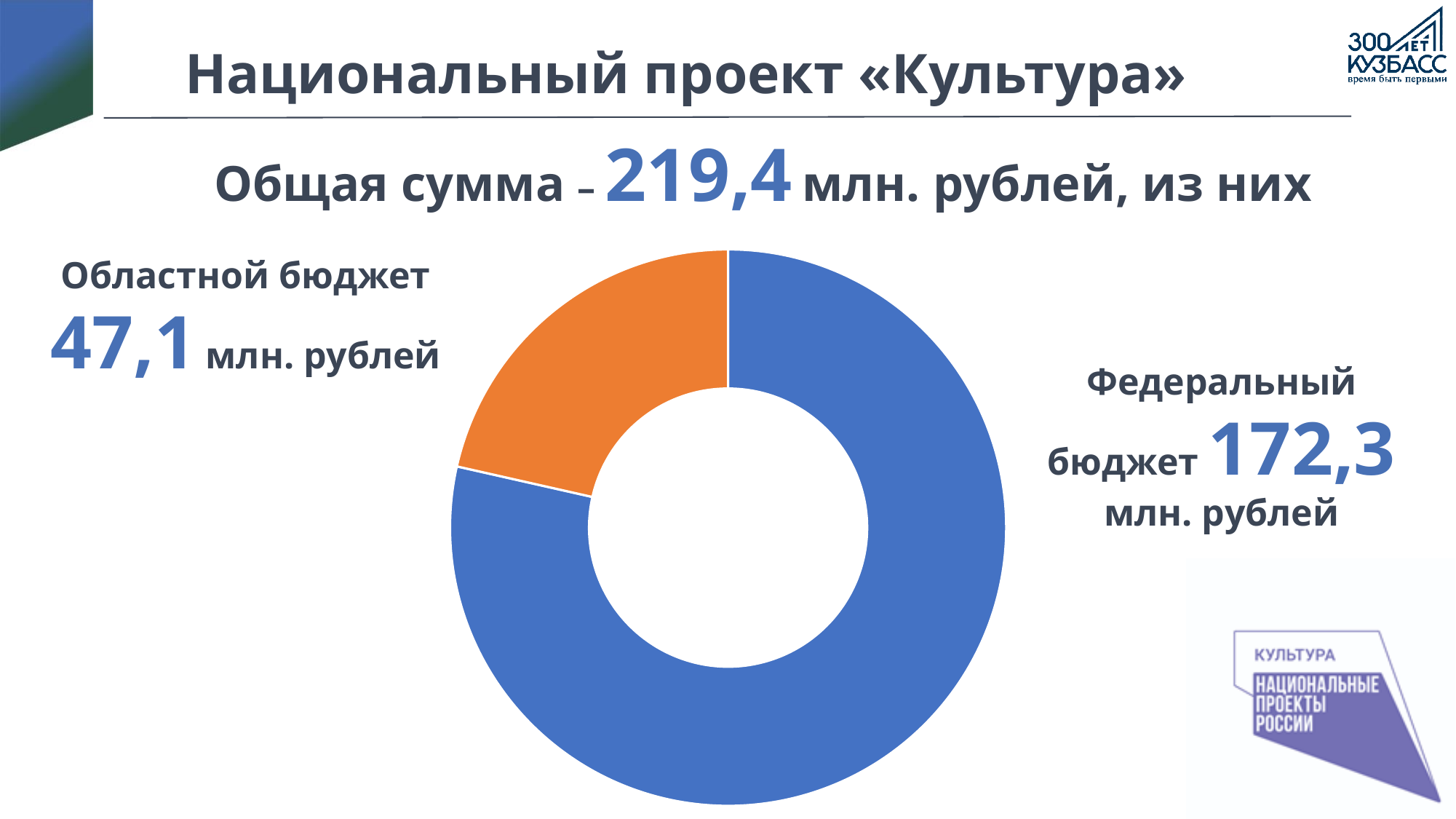
Which budget source has the largest segment in the chart? Федеральный бюджет What is the total of the two segments in the chart? 219,4 млн. рублей What is the value for Федеральный бюджет? 172,3 млн. рублей What is the difference between the Федеральный бюджет and the Областной бюджет values? 125,2 млн. рублей What is the value for Областной бюджет? 47,1 млн. рублей What is the total sum (Общая сумма) shown on the slide? 219,4 млн. рублей Which budget source has the smallest segment in the chart? Областной бюджет What kind of chart is shown on the slide? Doughnut (pie) chart What colour is the segment for Федеральный бюджет? Blue Which is larger, the Областной бюджет or the Федеральный бюджет? Федеральный бюджет What colour is the segment for Областной бюджет? Orange How many segments does the chart have? 2